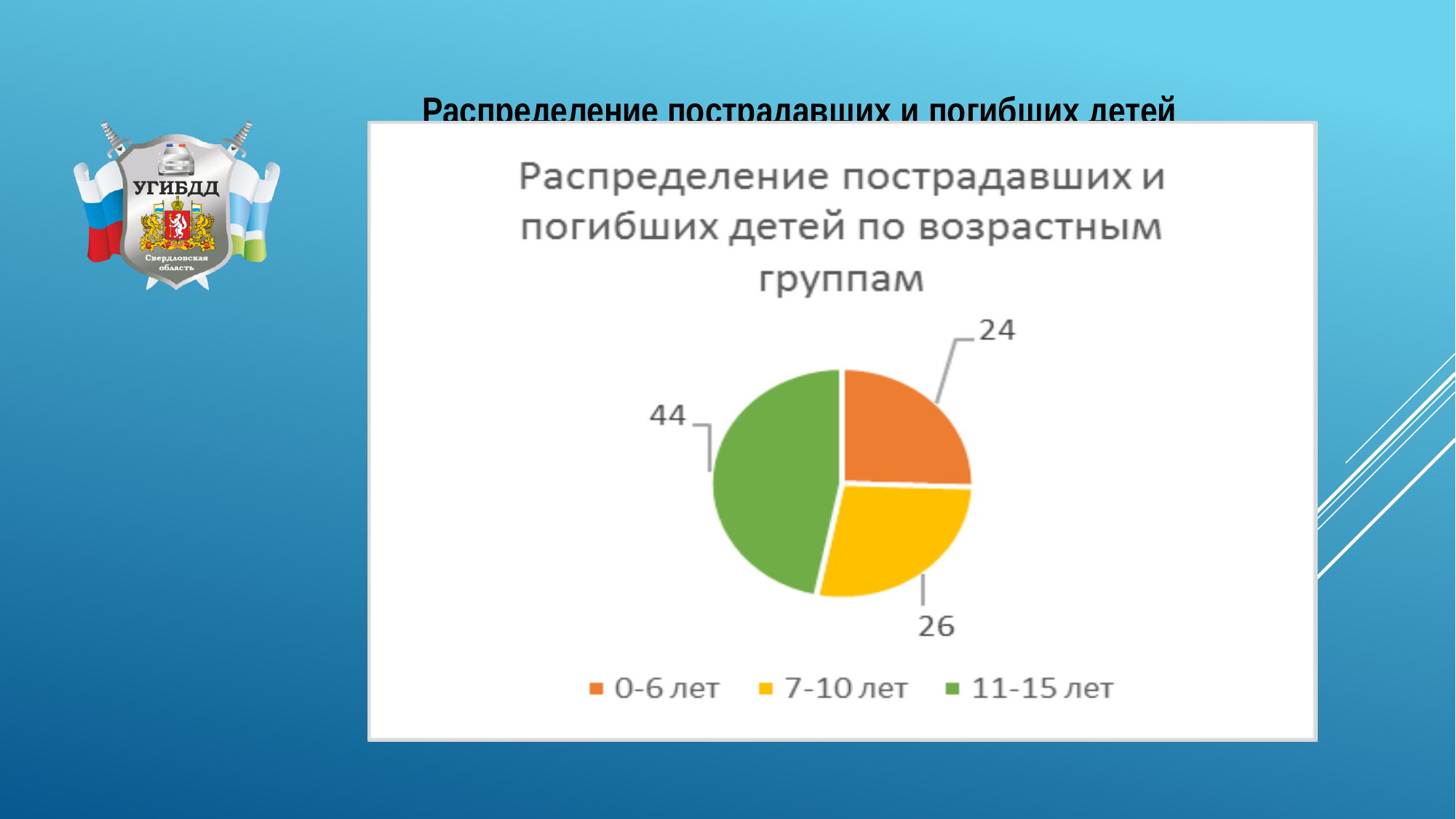
What is the value for the 0-6 лет slice? 24 What is the total of all three slices? 94 What type of chart is shown on the slide? pie chart Which age group has the smallest slice? 0-6 лет Which is larger, the value for 11-15 лет or the value for 7-10 лет? 11-15 лет What is the difference between the values for 11-15 лет and 0-6 лет? 20 Which age group has the largest slice? 11-15 лет How many slices does the pie chart have? 3 What is the value for the 11-15 лет slice? 44 What colour is the 11-15 лет slice? green What is the value for the 7-10 лет slice? 26 What is the difference between the values for 7-10 лет and 0-6 лет? 2